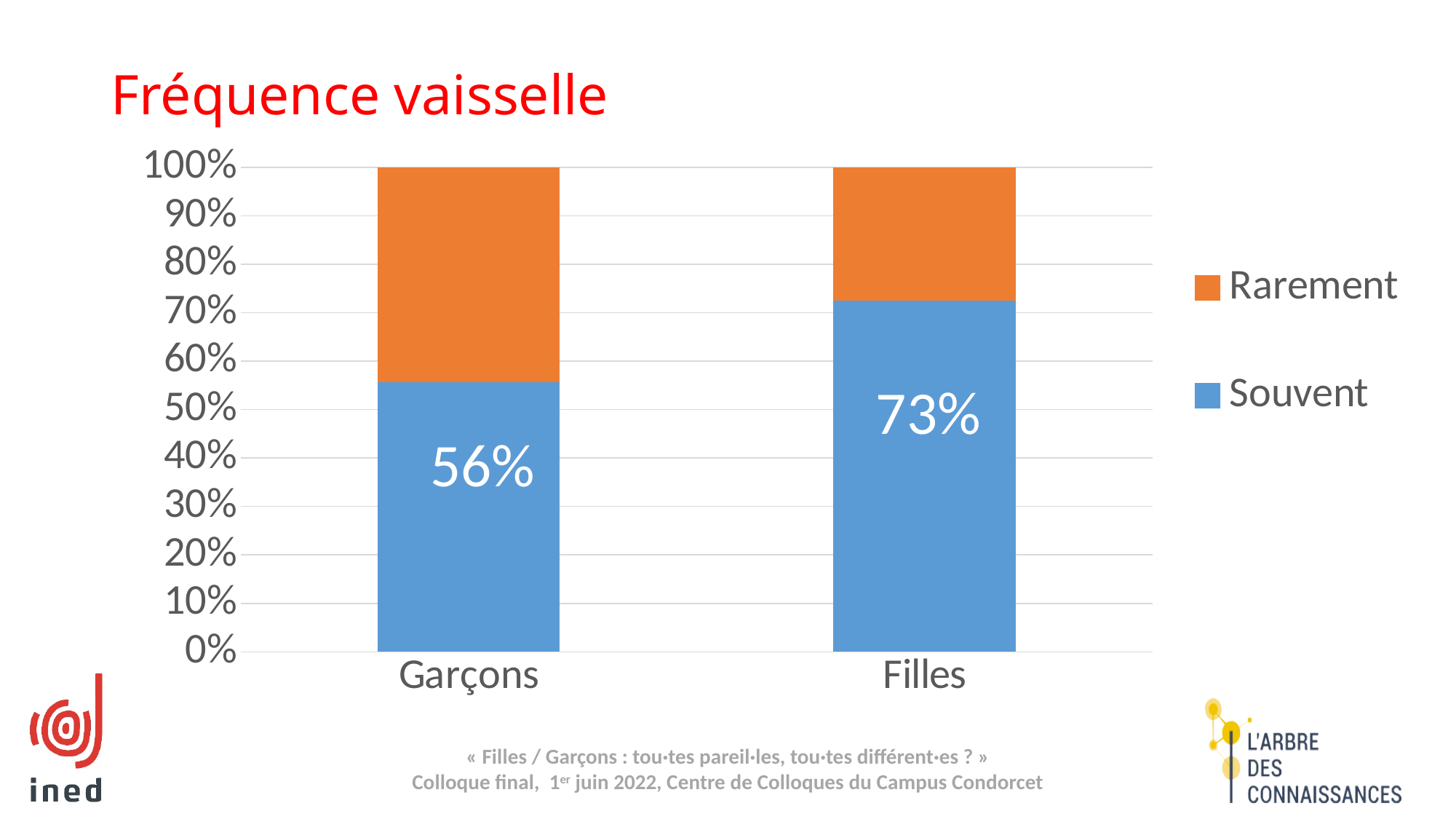
What is the difference between the Souvent values for Filles and Garçons? 17 percentage points Is the Souvent value larger for Garçons or for Filles? Filles Is the Rarement value for Garçons greater or less than 40%? greater How many categories are shown on the x axis? 2 Is the Rarement value for Filles greater or less than 30%? less What is the title of the chart? Fréquence vaisselle Which category has the higher Souvent value? Filles What kind of chart is shown on the slide? Stacked bar chart What is the value of Souvent for Filles? 73% How many series does the legend list? 2 What is the value of Souvent for Garçons? 56% Which category has the lower Souvent value? Garçons